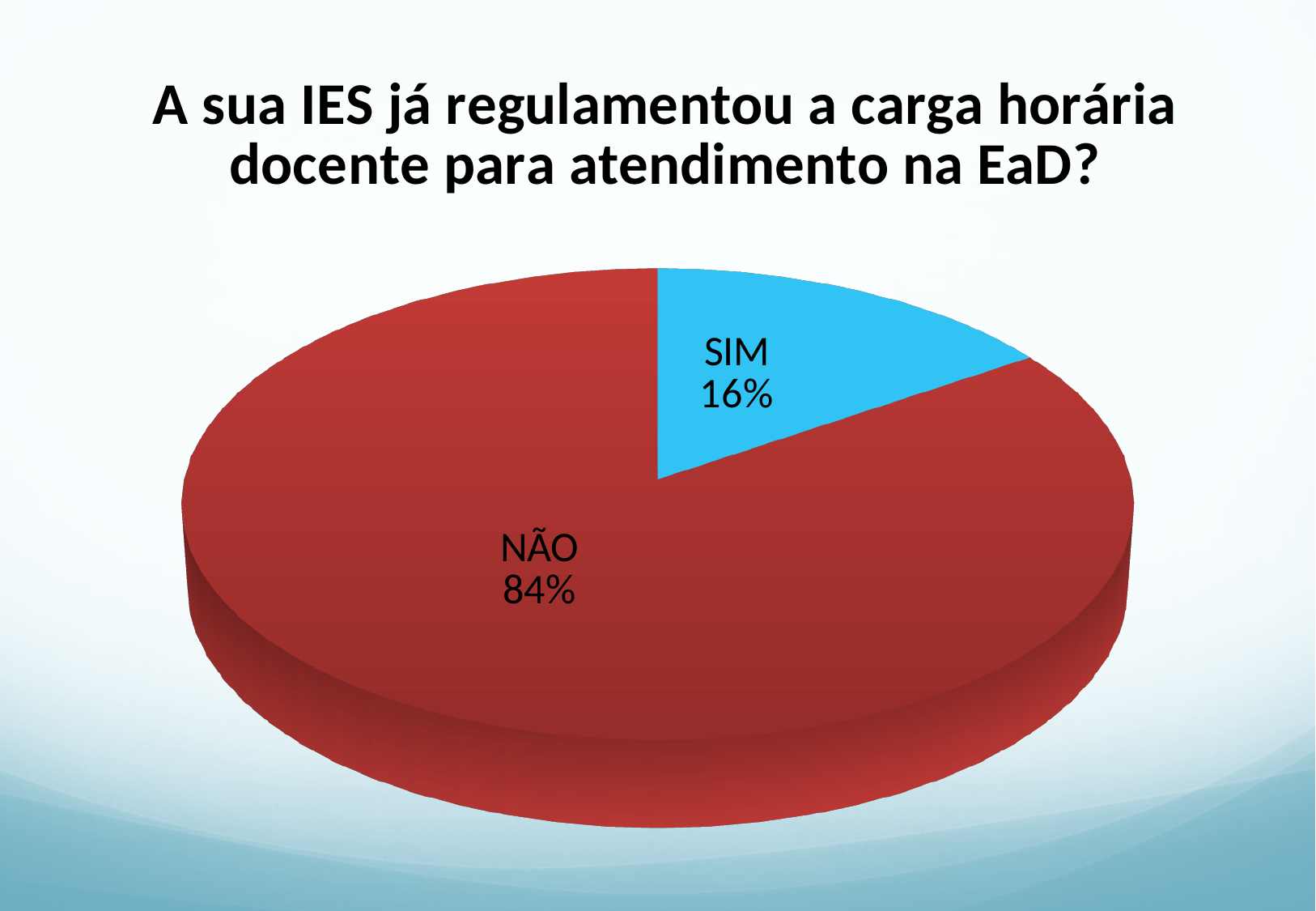
How many slices does the pie chart have? 2 What percentage of the pie is labelled SIM? 16% What is the title of the chart on the slide? A sua IES já regulamentou a carga horária docente para atendimento na EaD? What percentage of the pie is labelled NÃO? 84% Which is larger, the SIM slice or the NÃO slice? NÃO What colour is the NÃO slice of the pie? Red Which slice of the pie is the smallest? SIM What is the difference in percentage points between the NÃO slice and the SIM slice? 68 What share of the pie does the SIM slice represent? 16% Which slice of the pie is the largest? NÃO What kind of chart is shown on the slide? Pie chart